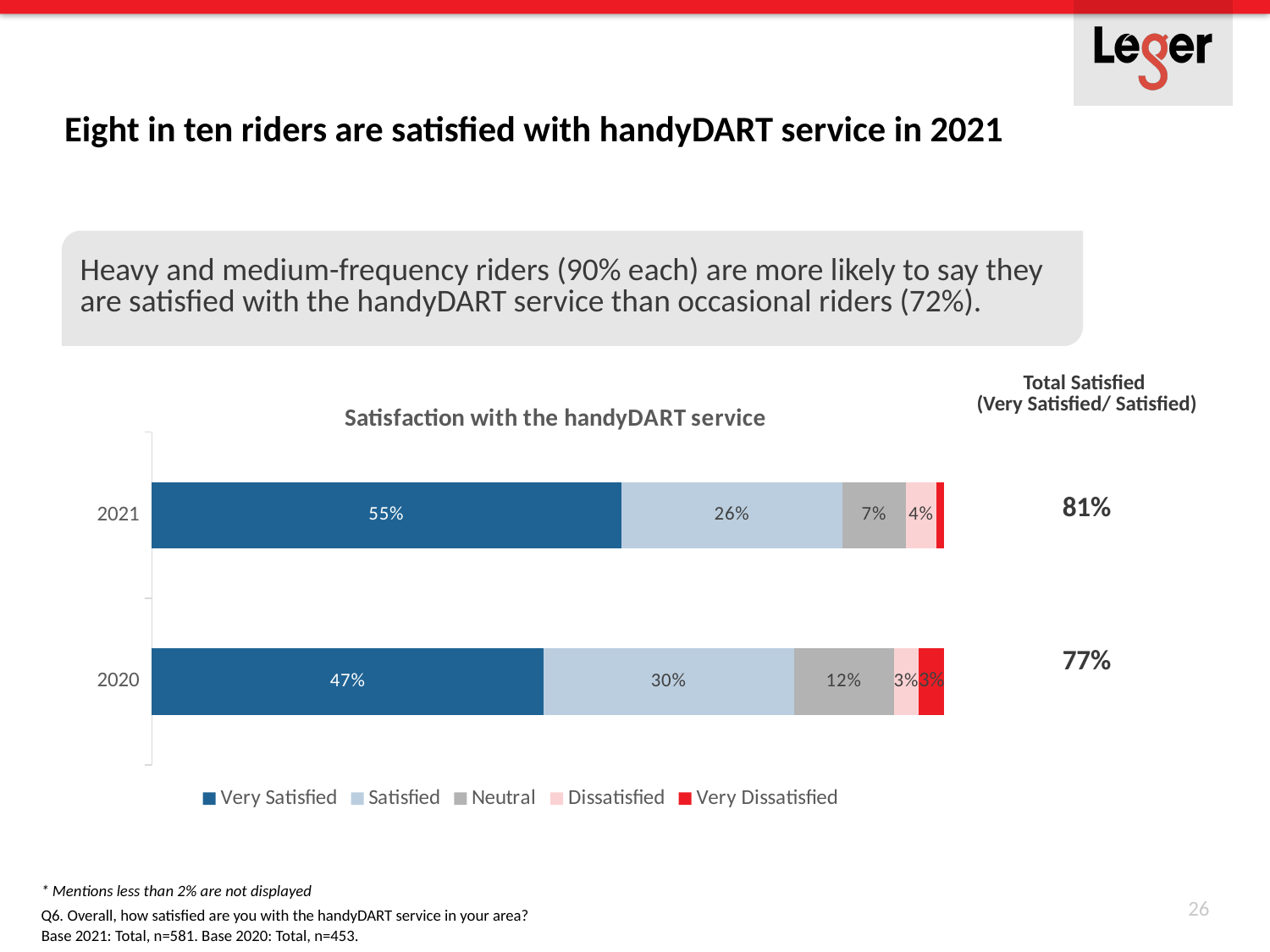
What is the title of the chart? Satisfaction with the handyDART service What type of chart is used to show satisfaction with the handyDART service? Stacked bar chart What is the Total Satisfied (Very Satisfied/Satisfied) figure shown for 2021? 81% How many years are shown on the chart? 2 By how many percentage points did the Very Satisfied share change from 2020 to 2021? 8 percentage points Which year had the larger Neutral share, 2020 or 2021? 2020 What percentage of riders were Satisfied (not Very Satisfied) in 2020? 30% What percentage of riders were Very Satisfied with the handyDART service in 2021? 55% What percentage of riders were Dissatisfied in 2020? 3% How many series does the legend list? 5 What percentage of riders were Neutral in 2021? 7% Which year had the higher Total Satisfied figure? 2021